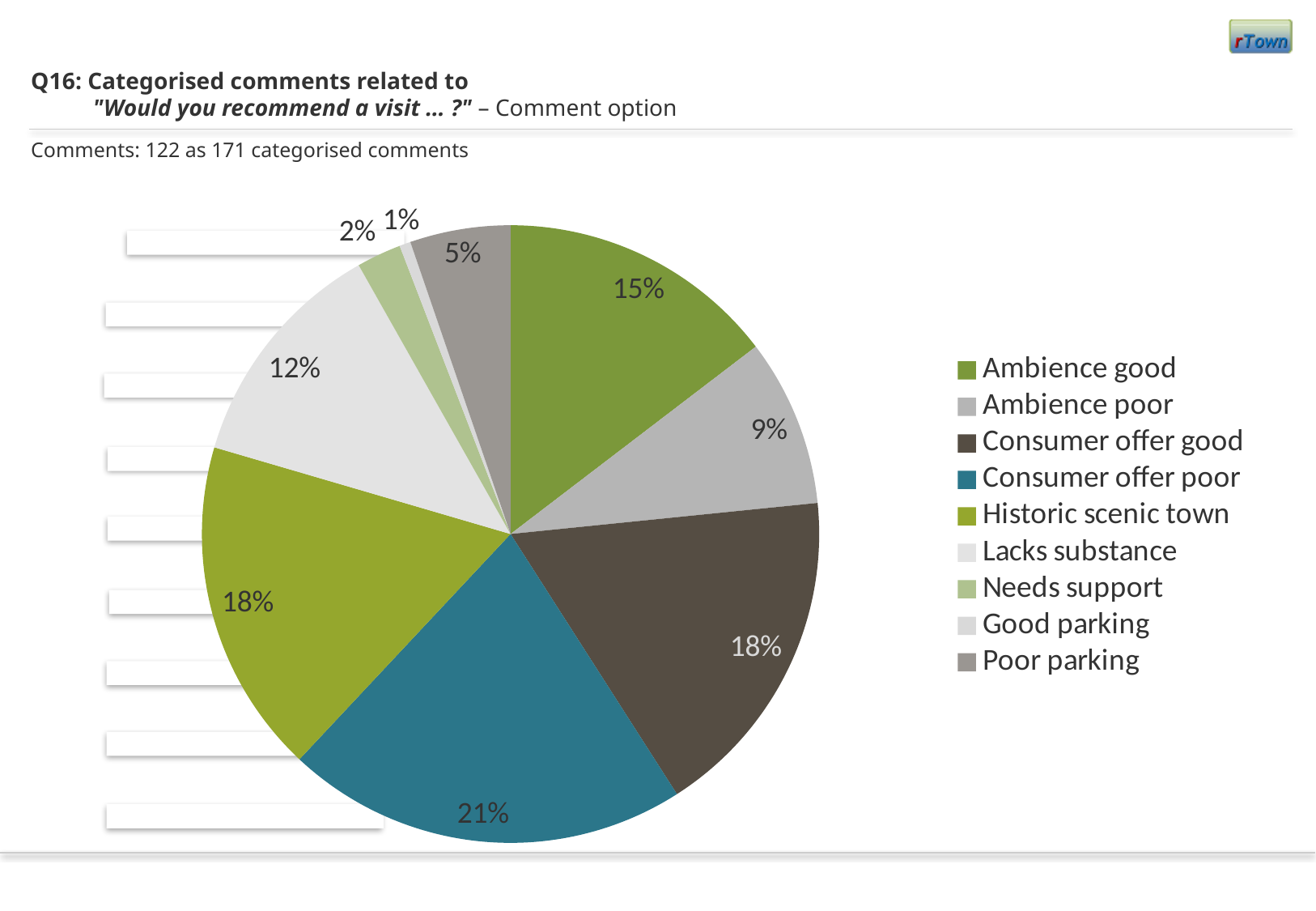
How many categories does the legend list? 9 What share of the pie does Lacks substance have? 12% What kind of chart is shown on the slide? pie chart What share of the pie does Ambience good have? 15% Which is larger, the share for Lacks substance or the share for Ambience good? Ambience good Which category has the largest slice of the pie? Consumer offer poor Which category has the smallest slice of the pie? Good parking What is the difference in percentage points between Consumer offer poor and Ambience poor? 12 What share of the pie does Consumer offer poor have? 21% How many categorised comments does the slide say the chart is based on? 171